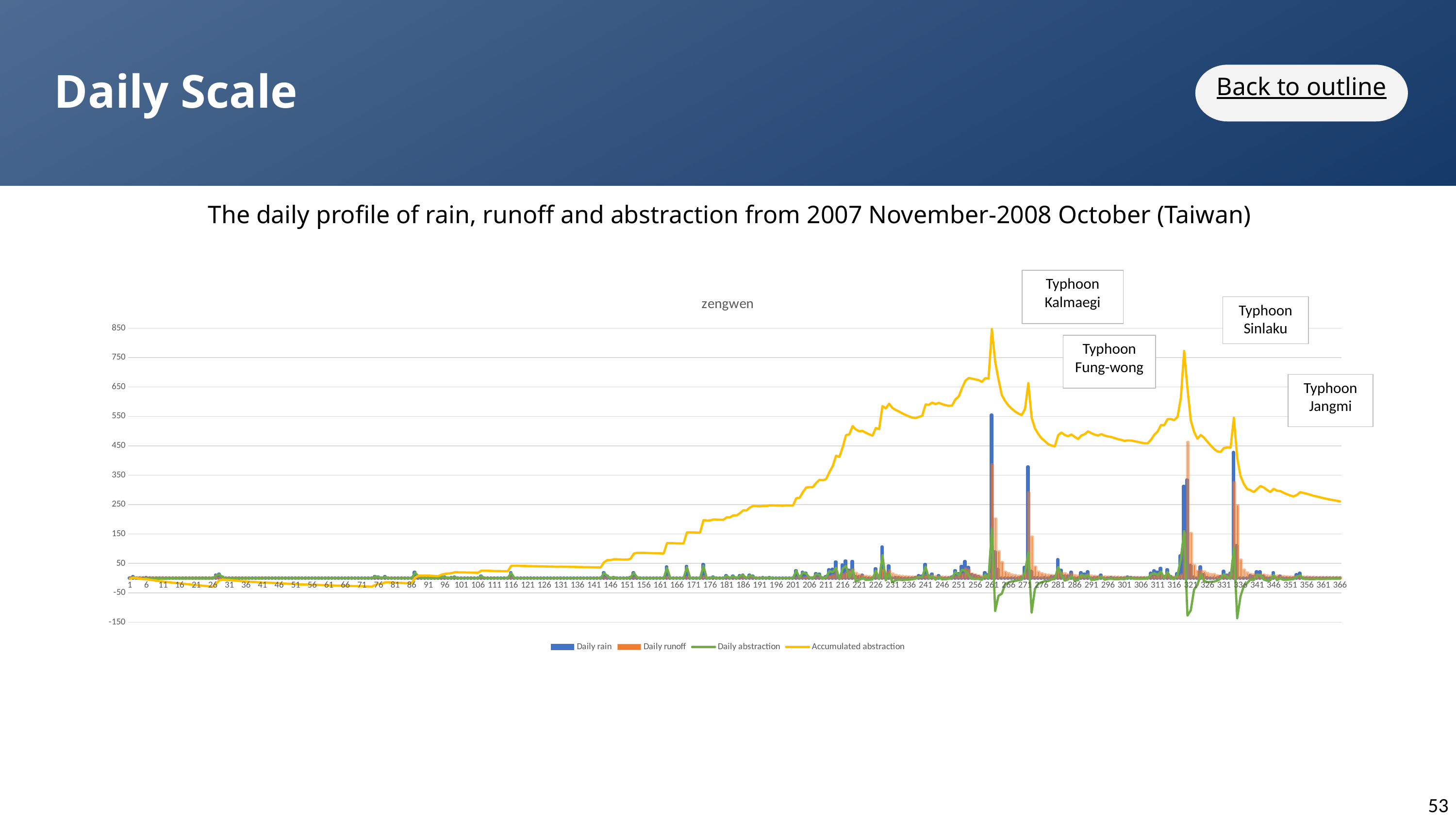
Is the Daily rain value at day 261 greater or less than 450? greater Which series is plotted as bars rather than a line: Daily rain or Accumulated abstraction? Daily rain How many typhoons are labelled on the chart? 4 What colour is the Accumulated abstraction series drawn in? Yellow Does the Accumulated abstraction series rise or fall between day 1 and day 261? rise What is the title shown above the plot area of the chart? zengwen Is the peak value of the Accumulated abstraction series greater or less than 750? greater How many series does the legend list? 4 Is the Accumulated abstraction value at day 366 greater or less than 350? less Which series reaches the highest value on the chart? Accumulated abstraction What is the highest value shown on the vertical axis? 850